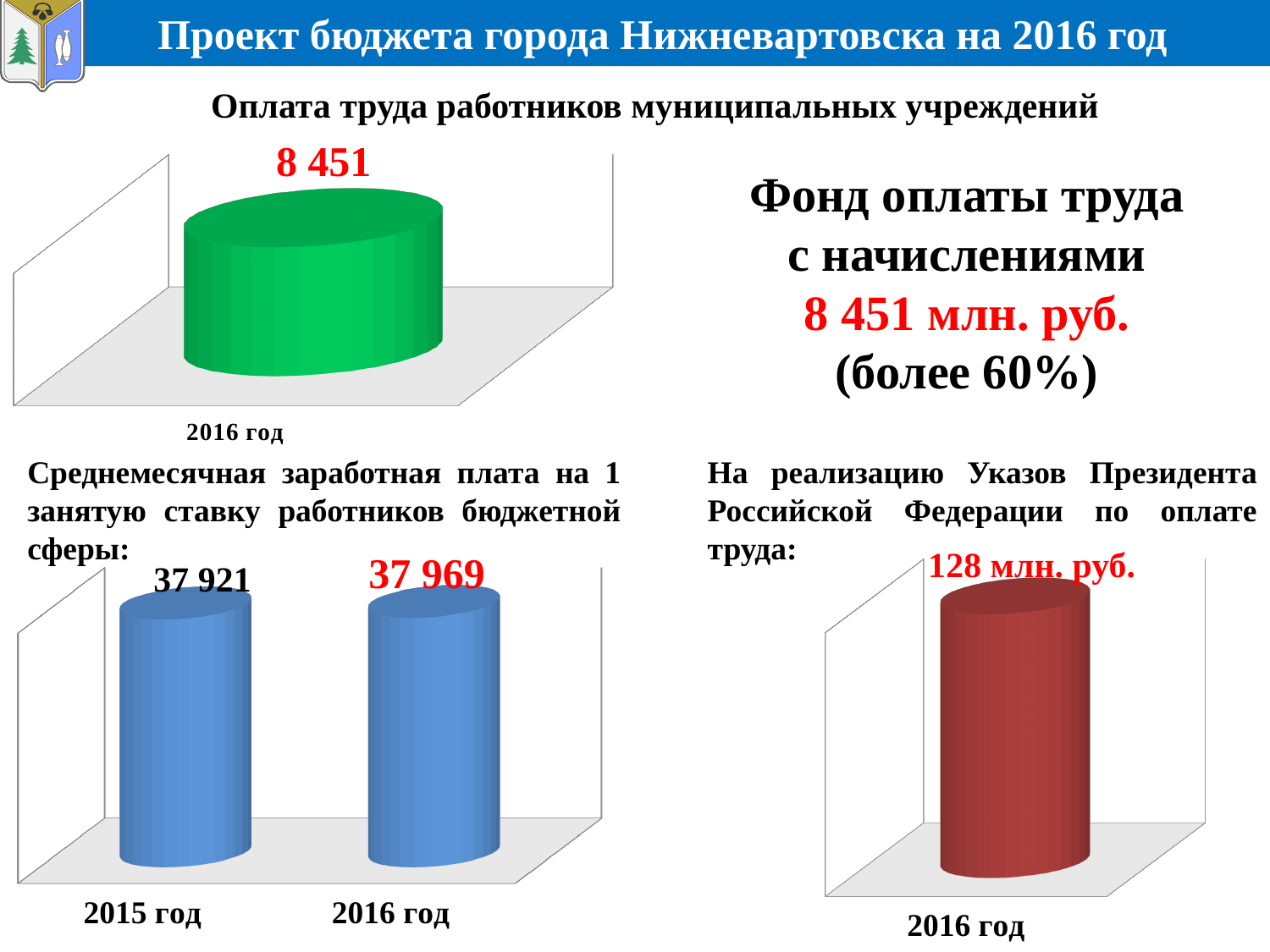
In the bottom-left chart, what is the value for 2015 год? 37 921 How many categories are shown in the bottom-left chart? 2 In the bottom-left chart, which year has the higher value? 2016 год What kind of chart is the bottom-left chart? bar chart How many categories are shown in the top-left chart? 1 In the bottom-left chart, which year has the lower value? 2015 год In the top-left chart, what is the value shown for 2016 год? 8 451 In the bottom-right chart, what is the value shown for 2016 год? 128 млн. руб. What colour is the bar in the bottom-right chart? red In the bottom-left chart, what is the difference between the 2016 год and 2015 год values? 48 In the bottom-left chart, is the value for 2016 год larger or smaller than the value for 2015 год? larger In the bottom-left chart, what is the value for 2016 год? 37 969